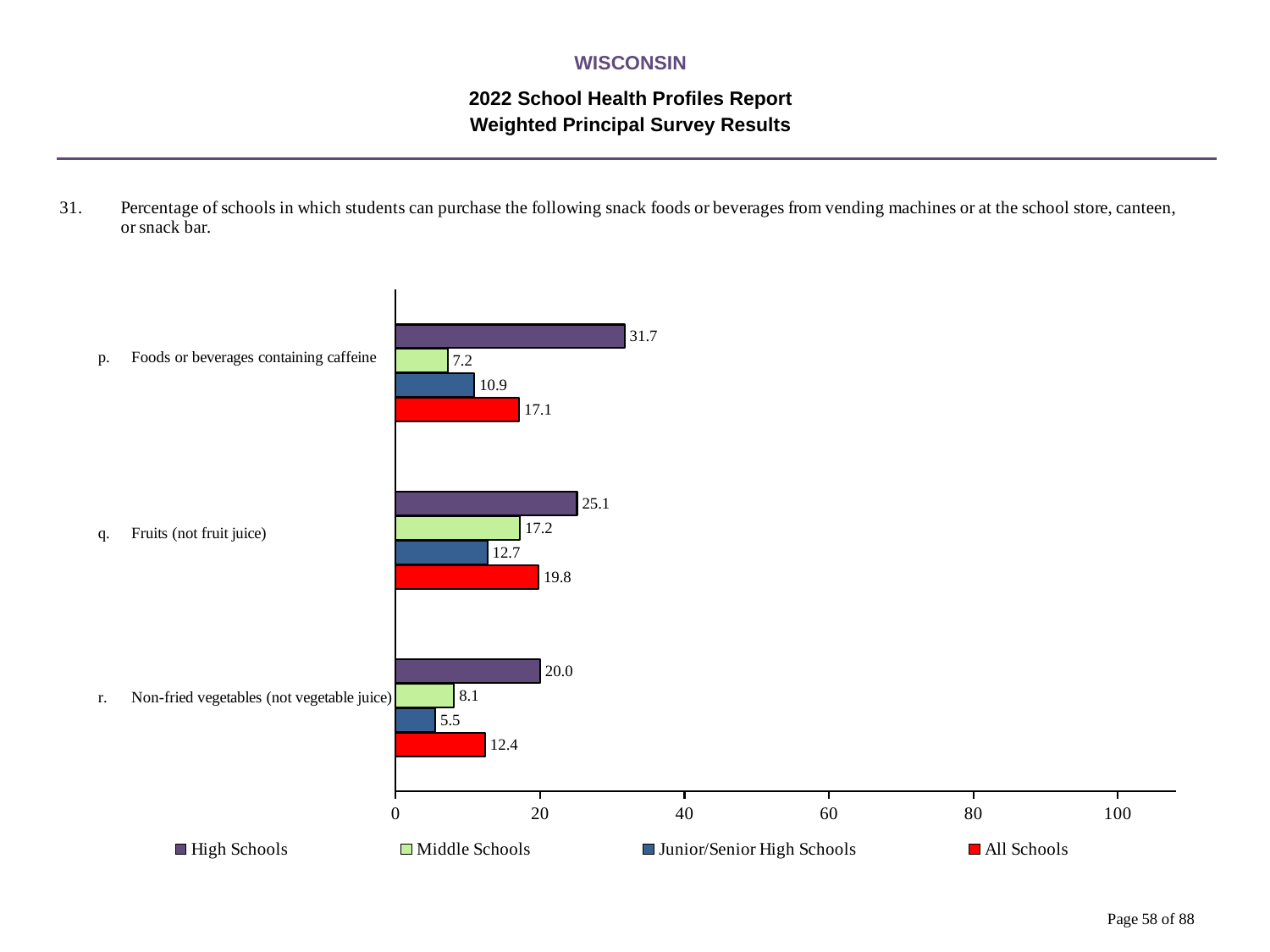
What is the value for All Schools for "Fruits (not fruit juice)"? 19.8 Is the All Schools value for "Foods or beverages containing caffeine" greater or less than 20? less How many snack food or beverage categories are shown on the chart? 3 How many series does the legend list? 4 What is the value for Junior/Senior High Schools for "Non-fried vegetables (not vegetable juice)"? 5.5 Which school type has the highest value for "Foods or beverages containing caffeine"? High Schools What is the difference between the High Schools and Middle Schools values for "Foods or beverages containing caffeine"? 24.5 Which is larger for "Fruits (not fruit juice)": the Middle Schools value or the Junior/Senior High Schools value? Middle Schools What is the value for Middle Schools for "Fruits (not fruit juice)"? 17.2 Which school type has the lowest value for "Non-fried vegetables (not vegetable juice)"? Junior/Senior High Schools What is the value for High Schools for "Foods or beverages containing caffeine"? 31.7 What kind of chart is shown on the slide? bar chart